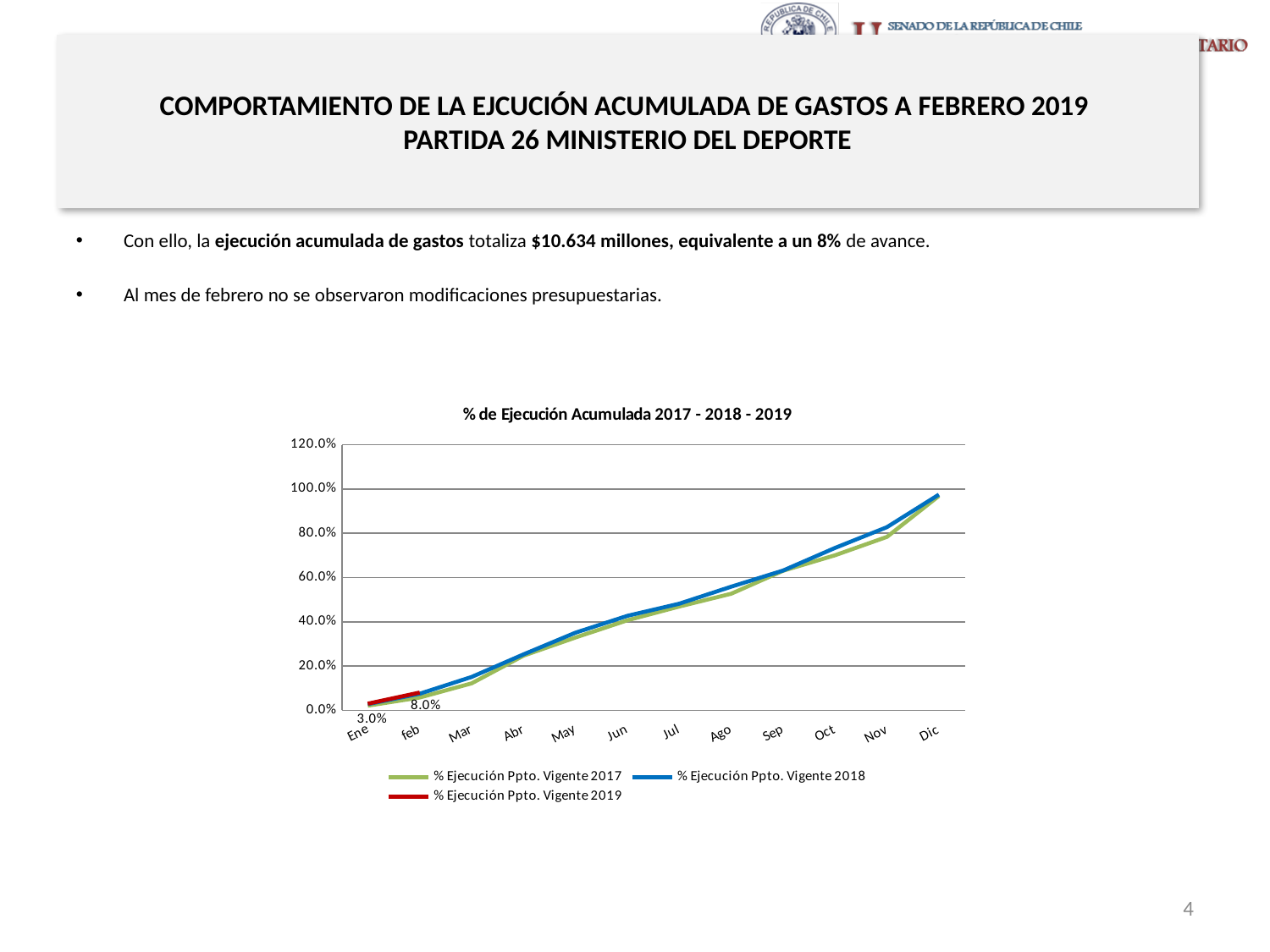
What is the difference between the feb and Ene values of % Ejecución Ppto. Vigente 2019? 5.0% How many months are shown along the x axis of the chart? 12 Which series is drawn in red in the chart? % Ejecución Ppto. Vigente 2019 What is the title of the chart? % de Ejecución Acumulada 2017 - 2018 - 2019 Is the value for % Ejecución Ppto. Vigente 2018 in Dic greater or less than 80.0%? greater Is the value for % Ejecución Ppto. Vigente 2017 in Jun greater or less than 60.0%? less What is the value of % Ejecución Ppto. Vigente 2019 for Ene? 3.0% What kind of chart is shown on the slide? line chart Do the values of % Ejecución Ppto. Vigente 2018 rise or fall from Ene to Dic? rise How many series does the chart legend list? 3 What is the value of % Ejecución Ppto. Vigente 2019 for feb? 8.0% Is the value for % Ejecución Ppto. Vigente 2018 in Sep greater or less than 40.0%? greater